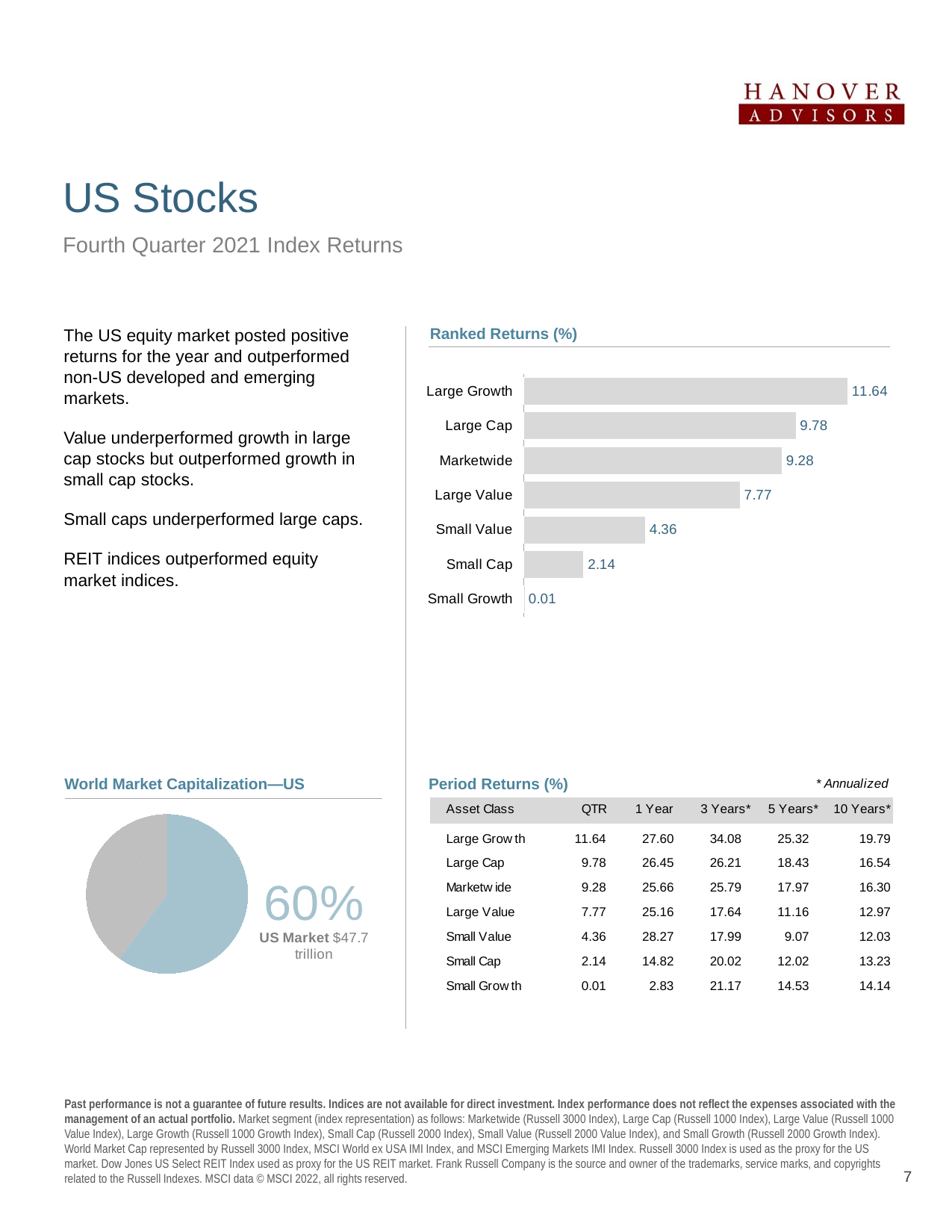
In the Ranked Returns (%) chart, which is larger, Marketwide or Small Cap? Marketwide In the Ranked Returns (%) chart, what is the value for Small Value? 4.36 What kind of chart is the World Market Capitalization—US chart? Pie chart In the Ranked Returns (%) chart, which category has the lowest value? Small Growth How many categories are shown in the Ranked Returns (%) chart? 7 What is the title of the bar chart on the slide? Ranked Returns (%) In the World Market Capitalization—US pie chart, what share does the US Market represent? 60% In the Ranked Returns (%) chart, what is the value for Large Cap? 9.78 In the Ranked Returns (%) chart, what is the difference between Small Value and Small Cap? 2.22 In the Ranked Returns (%) chart, which category has the highest value? Large Growth What kind of chart is the Ranked Returns (%) chart? Bar chart In the Ranked Returns (%) chart, what is the difference between Large Growth and Large Value? 3.87